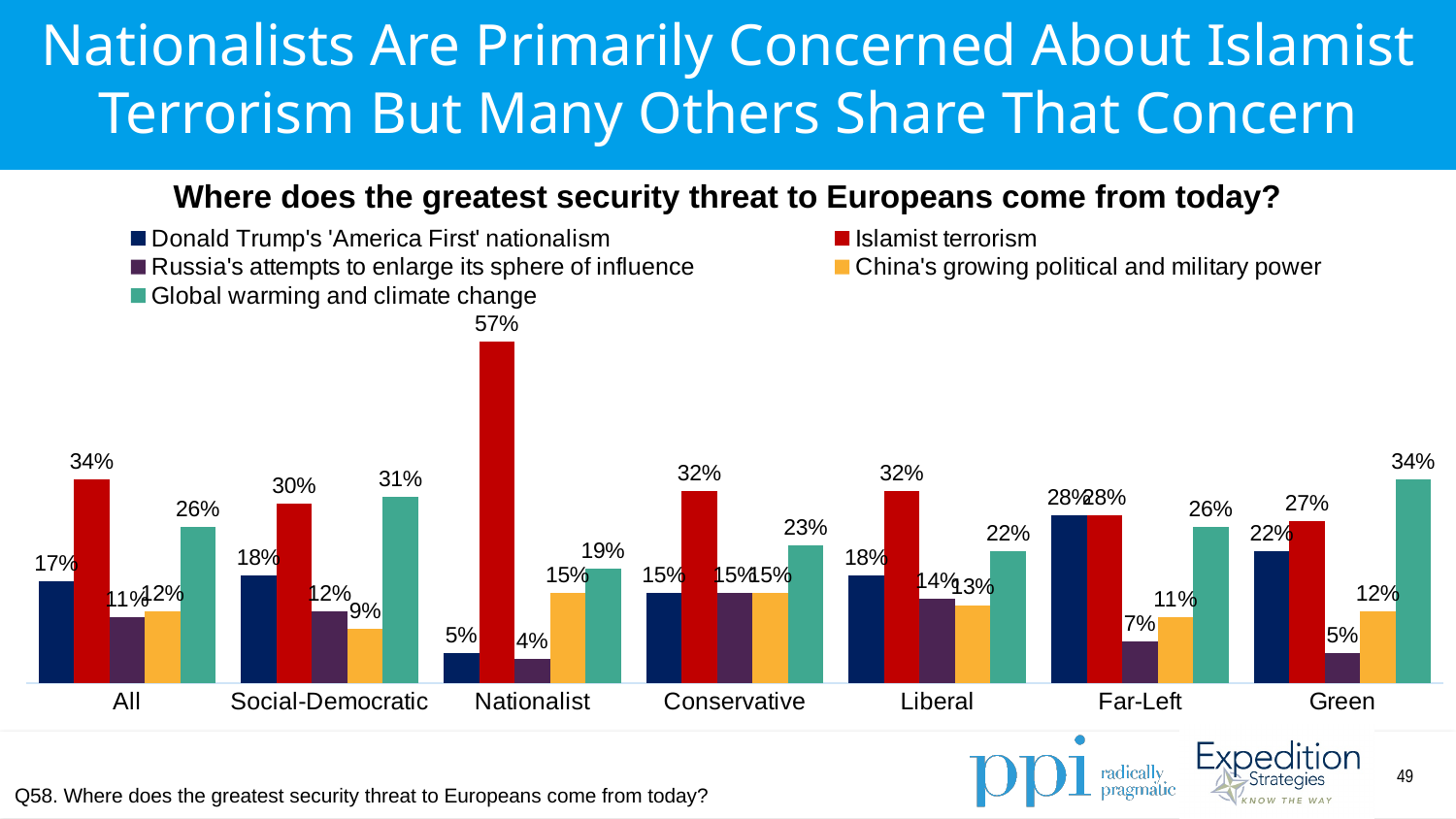
How many series does the legend list? 5 How many percentage points higher is the Islamist terrorism value for Nationalist respondents than for All respondents? 23 percentage points What is the value for Global warming and climate change among Green respondents? 34% Which group has the highest value for Islamist terrorism? Nationalist What kind of chart is shown on the slide? Bar chart What is the value for China's growing political and military power among Nationalist respondents? 15% What is the title of the chart? Where does the greatest security threat to Europeans come from today? How many respondent groups are shown on the x axis? 7 What is the value for Russia's attempts to enlarge its sphere of influence among Far-Left respondents? 7% Which group has the lowest value for Donald Trump's 'America First' nationalism? Nationalist Among Green respondents, which is larger: Global warming and climate change or Islamist terrorism? Global warming and climate change What percentage of Nationalist respondents named Islamist terrorism as the greatest security threat? 57%